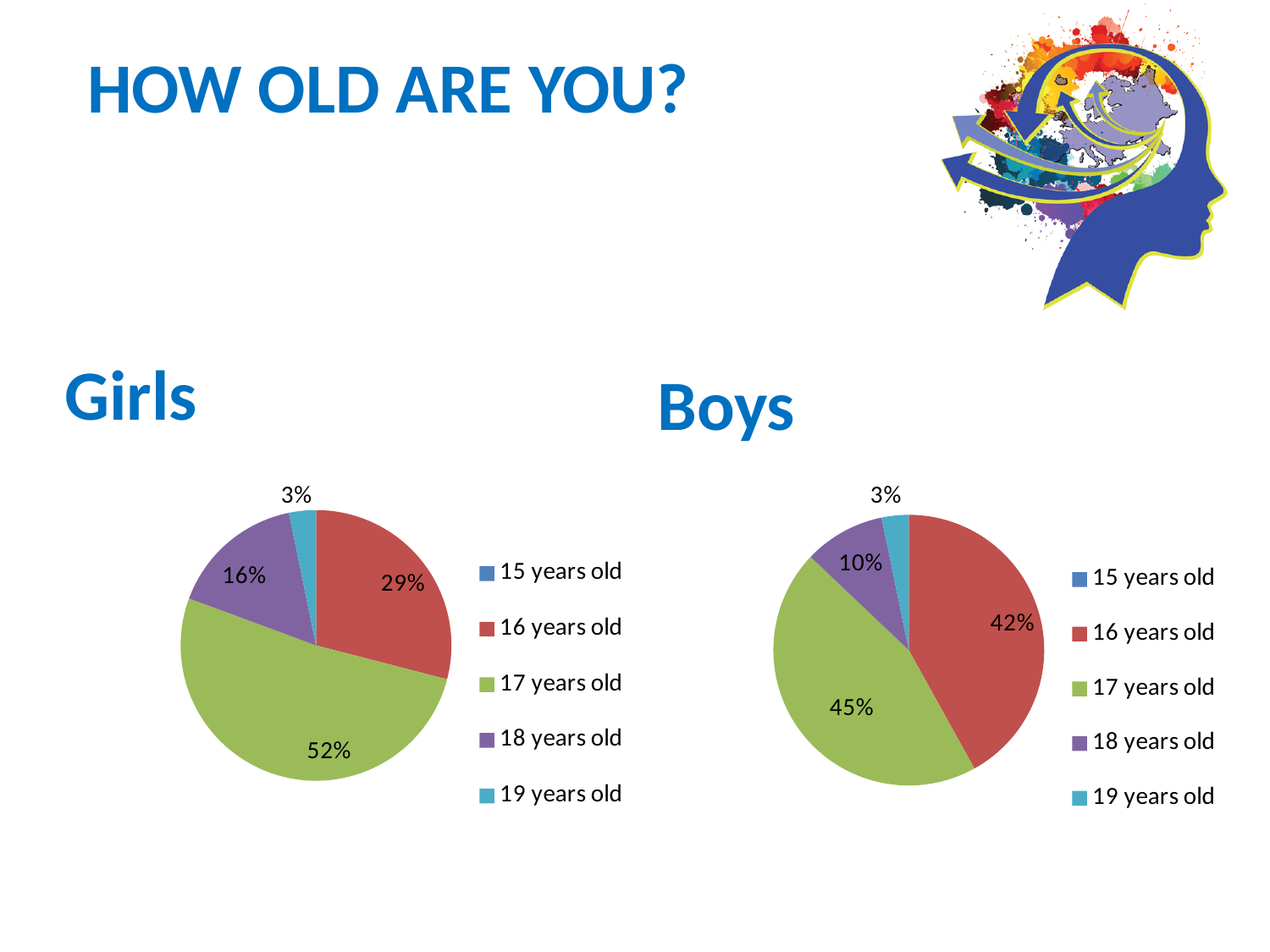
In the Girls chart, what is the difference between the share of 17-year-olds and the share of 16-year-olds? 23% In the Boys chart, what percentage of boys are 16 years old? 42% In the Girls chart, what percentage of girls are 18 years old? 16% In the Boys chart, what is the difference between the share of 17-year-olds and the share of 16-year-olds? 3% How many entries does the legend of the Girls chart list? 5 In the Girls chart, what percentage of girls are 17 years old? 52% In the Boys chart, which is larger: the share of 16-year-olds or the share of 18-year-olds? 16 years old In the Girls chart, which labelled age group has the smallest share? 19 years old In the Girls chart, which age group has the largest share? 17 years old In the Boys chart, which age group has the largest share? 17 years old What type of chart is the Boys chart? Pie chart In the Boys chart, what percentage of boys are 18 years old? 10%